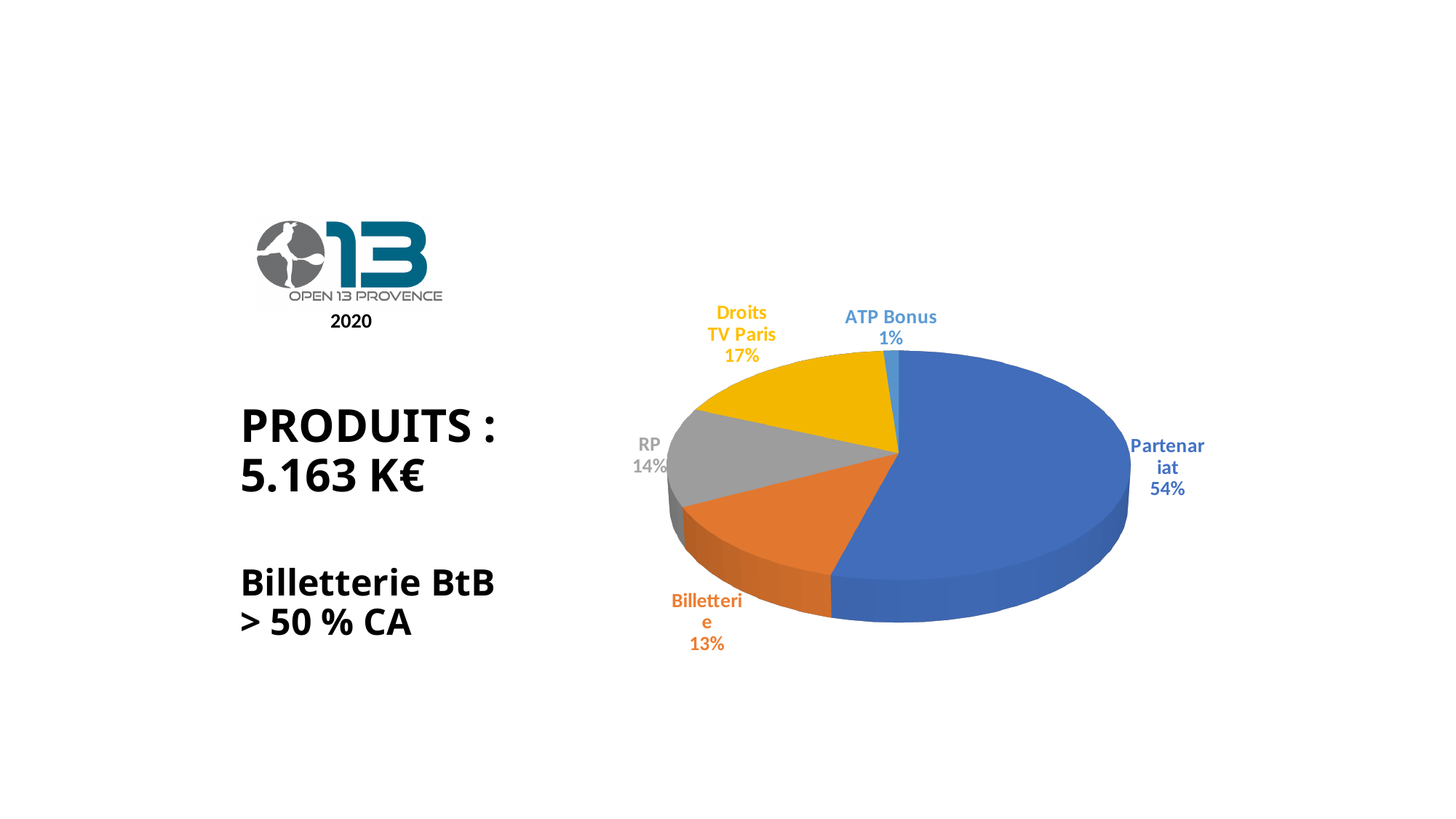
How many slices does the pie chart have? 5 What percentage is shown for Billetterie? 13% What is the difference in percentage points between Partenariat and Droits TV Paris? 37 Which is larger, the share for Droits TV Paris or the share for RP? Droits TV Paris Which category has the largest slice of the pie? Partenariat What percentage is shown for Droits TV Paris? 17% What colour is the Partenariat slice? Blue What share of the pie does Partenariat represent? 54% What kind of chart is shown on the slide? Pie chart What percentage is shown for ATP Bonus? 1% What percentage is shown for RP? 14% Which category has the smallest slice of the pie? ATP Bonus